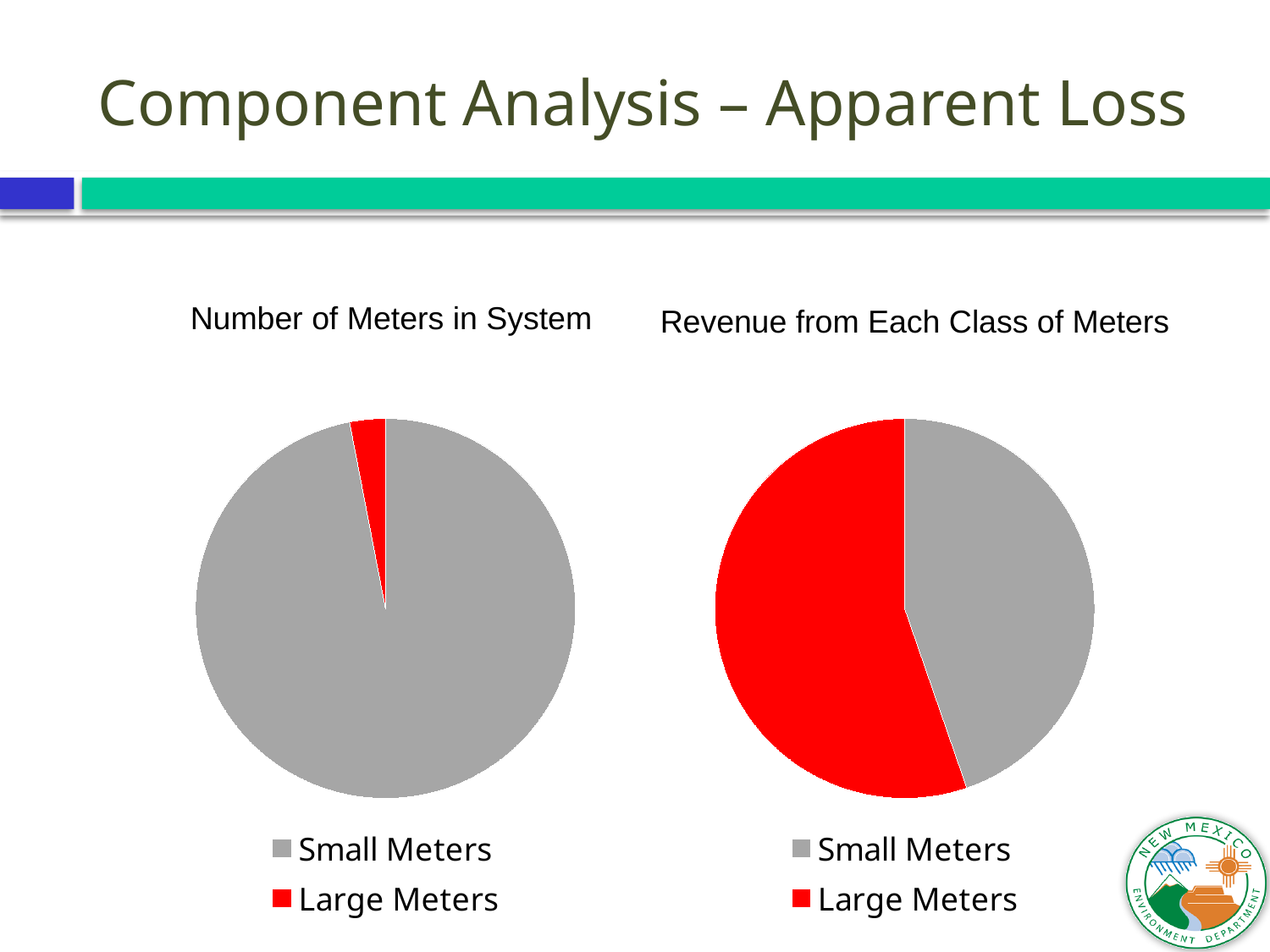
What kind of chart is the "Revenue from Each Class of Meters" chart? pie chart In the "Revenue from Each Class of Meters" chart, which category has the largest slice? Large Meters What kind of chart is the "Number of Meters in System" chart? pie chart In the "Revenue from Each Class of Meters" chart, which category has the smallest slice? Small Meters How many entries does the legend of the "Revenue from Each Class of Meters" chart list? 2 In the "Number of Meters in System" chart, what colour represents Large Meters? red How many slices does the "Number of Meters in System" pie chart have? 2 In the "Number of Meters in System" chart, which category has the largest slice? Small Meters In the "Number of Meters in System" chart, which slice is larger, Small Meters or Large Meters? Small Meters In the "Revenue from Each Class of Meters" chart, which slice is larger, Small Meters or Large Meters? Large Meters What is the title of the pie chart on the right side of the slide? Revenue from Each Class of Meters In the "Number of Meters in System" chart, which category has the smallest slice? Large Meters